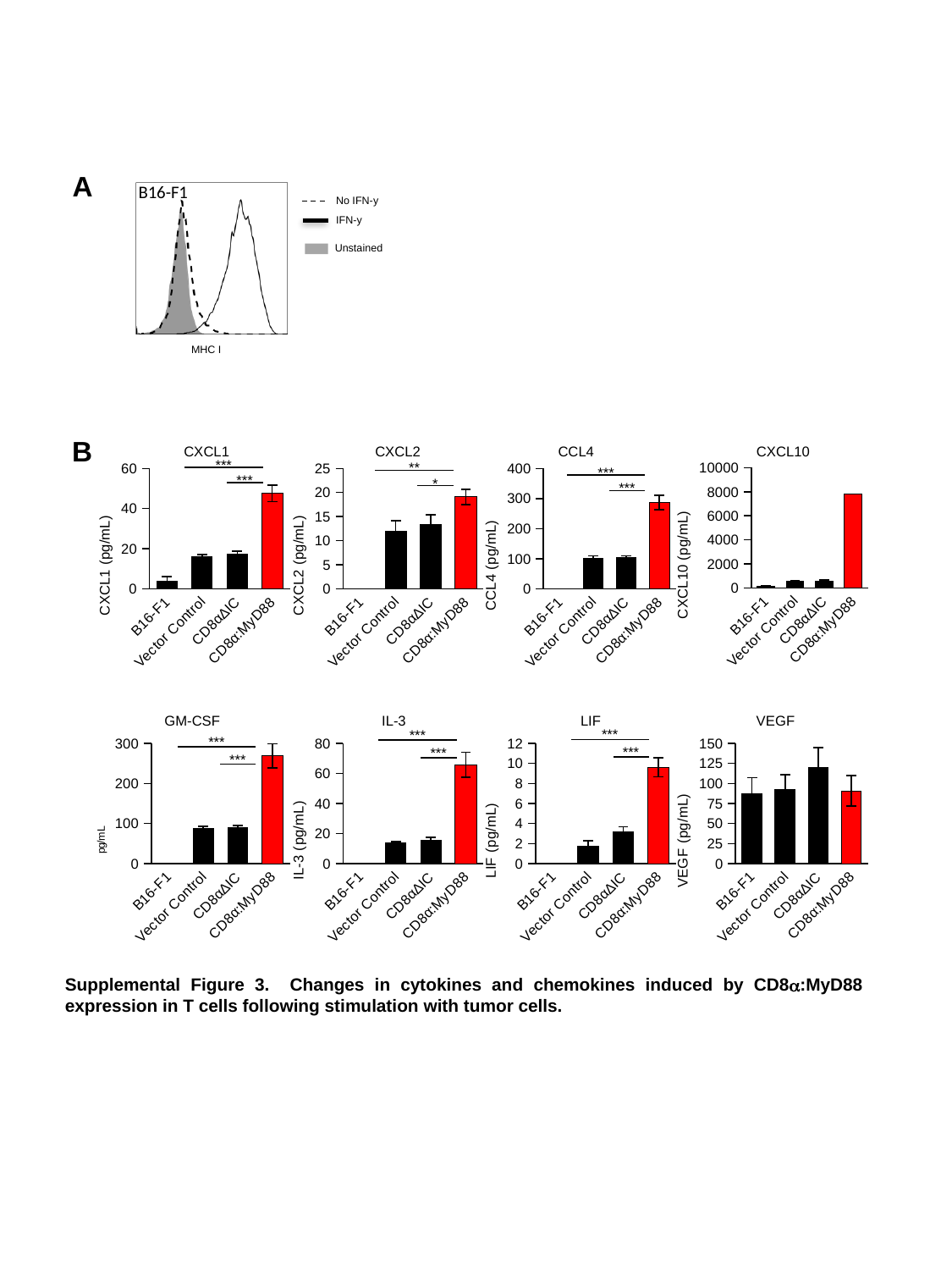
In the IL-3 chart, is the value for CD8α:MyD88 greater or less than 40? greater In the CXCL1 chart, is the value for CD8α:MyD88 greater or less than 40? greater In the GM-CSF chart, which is larger, the value for Vector Control or the value for CD8α:MyD88? CD8α:MyD88 In the CXCL10 chart, is the value for CD8α:MyD88 greater or less than 6000? greater In the CXCL1 chart, which category has the highest value? CD8α:MyD88 What kind of chart is the VEGF chart? bar chart In the VEGF chart, which category has the highest value? CD8αΔIC In the CXCL1 chart, which category has the lowest value? B16-F1 How many categories are shown on the x axis of the CCL4 chart? 4